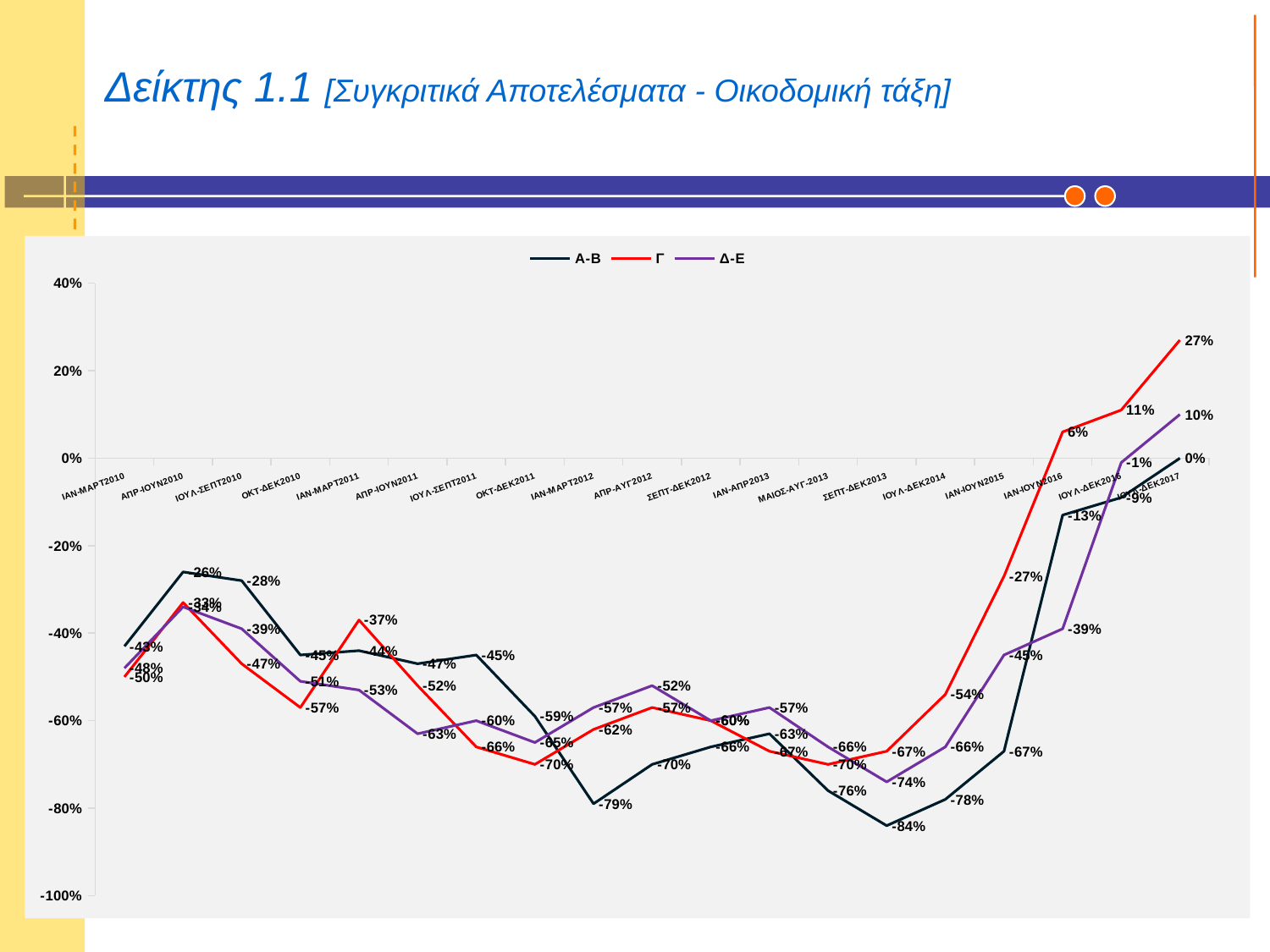
What is the difference between the Γ and Δ-Ε values at ΙΟΥΛ-ΔΕΚ2017? 17 percentage points How many series does the legend list? 3 In which period does the Γ series reach its highest value? ΙΟΥΛ-ΔΕΚ2017 In which period does the Α-Β series reach its lowest value? ΣΕΠΤ-ΔΕΚ2013 From ΣΕΠΤ-ΔΕΚ2013 to ΙΟΥΛ-ΔΕΚ2017, does the Α-Β series rise or fall? rise At ΙΑΝ-ΙΟΥΝ2016, which series has the higher value, Γ or Α-Β? Γ What is the value of the Α-Β series at ΣΕΠΤ-ΔΕΚ2013? -84% What is the value of the Γ series at ΙΟΥΛ-ΔΕΚ2017? 27% What kind of chart is shown on the slide? line chart What is the value of the Δ-Ε series at ΙΟΥΛ-ΔΕΚ2017? 10% What are the series names listed in the legend? Α-Β, Γ, Δ-Ε What is the value of the Α-Β series at ΙΑΝ-ΜΑΡΤ2012? -79%